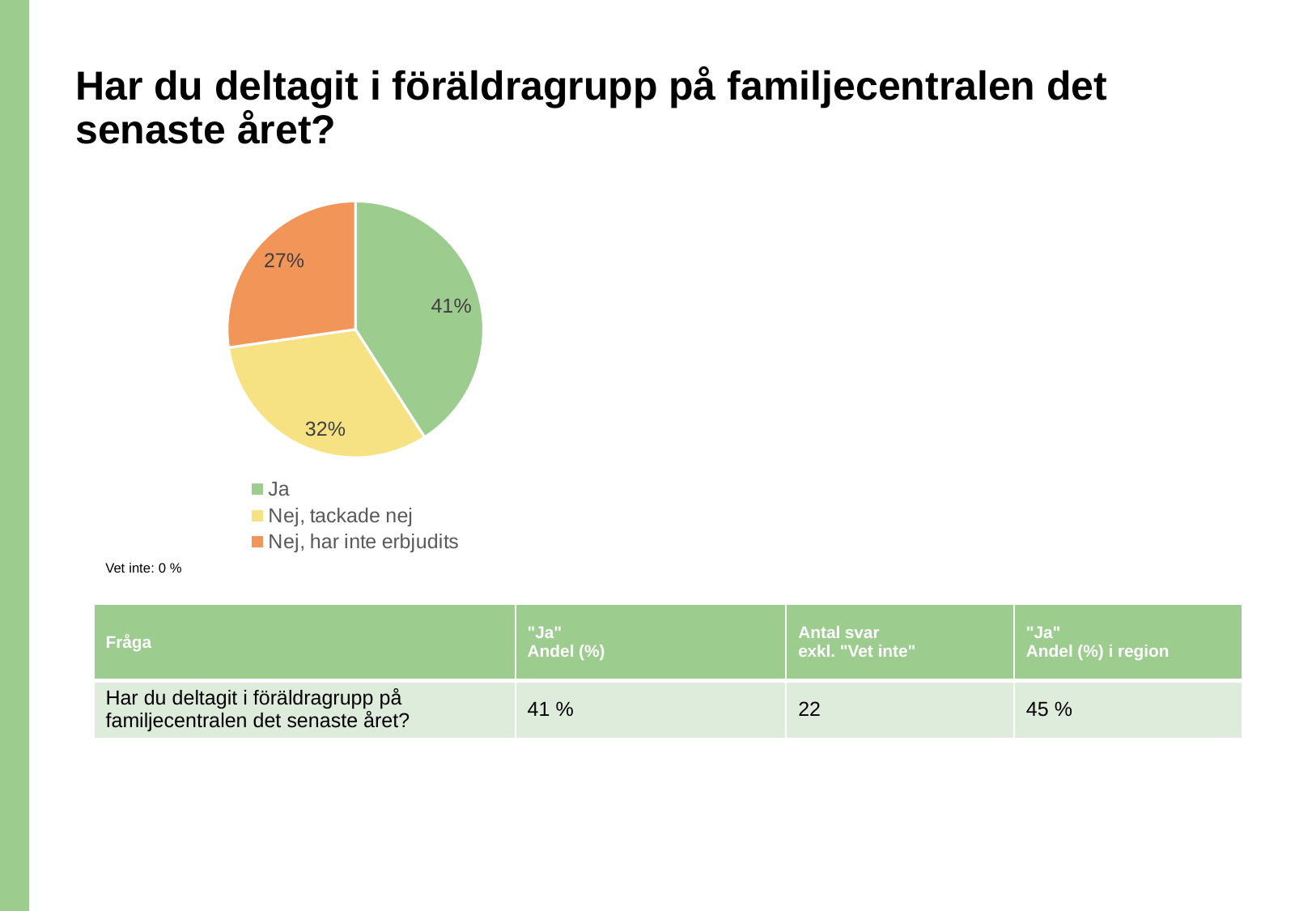
Which category has the smallest slice of the pie? Nej, har inte erbjudits Which is larger: the "Ja" slice or the "Nej, tackade nej" slice? Ja What is the difference in percentage points between the "Ja" slice and the "Nej, har inte erbjudits" slice? 14 What kind of chart is shown on the slide? pie chart How many categories does the pie chart show? 3 What is the difference in percentage points between the "Nej, tackade nej" slice and the "Nej, har inte erbjudits" slice? 5 Which colour represents "Ja" in the pie chart? green What share of the pie does "Nej, tackade nej" represent? 32% Which category has the largest slice of the pie? Ja Which colour represents "Nej, har inte erbjudits" in the pie chart? orange What share of the pie does "Ja" represent? 41% What share of the pie does "Nej, har inte erbjudits" represent? 27%